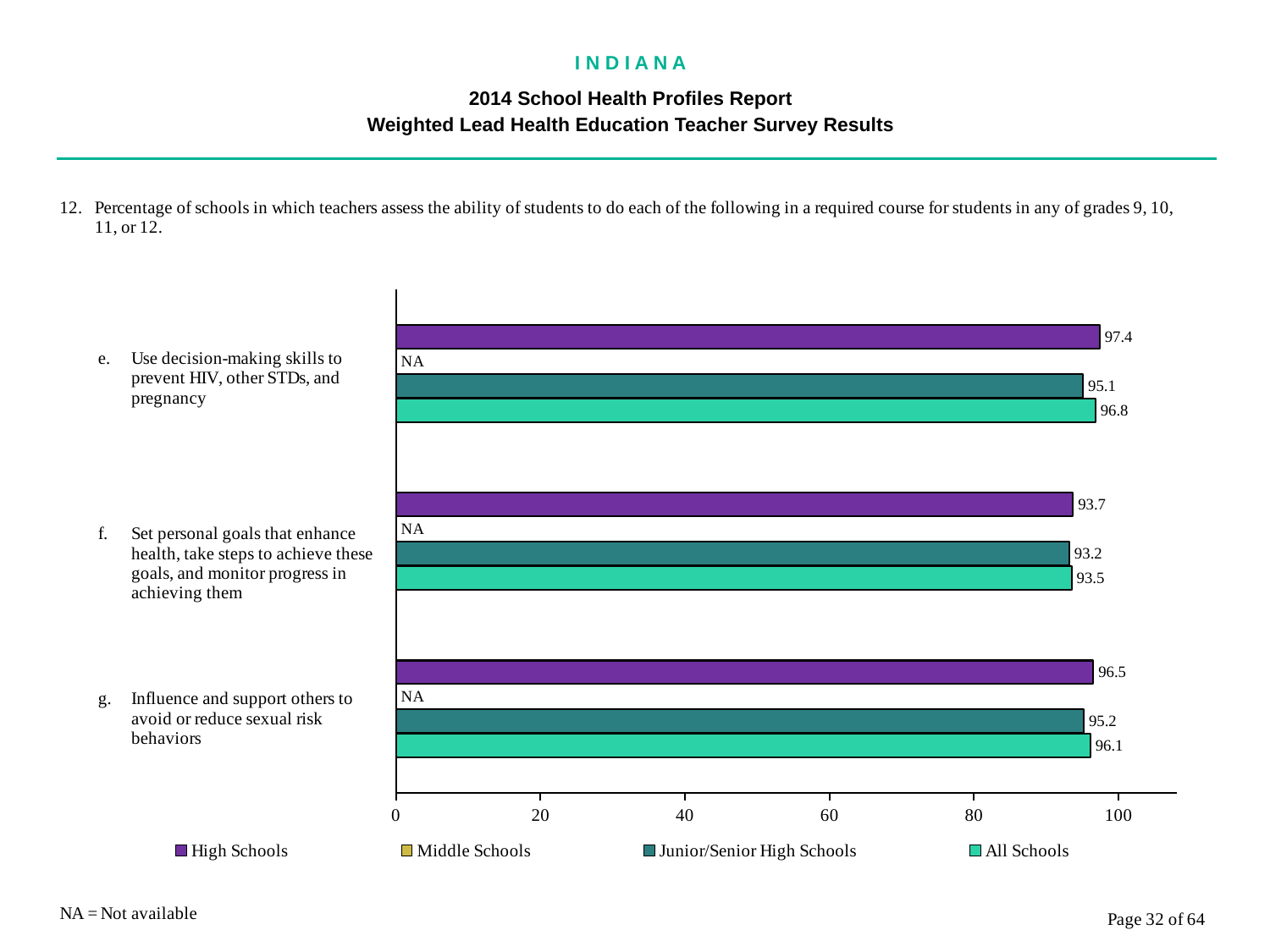
Which legend entry is shown in purple? High Schools What is the Junior/Senior High Schools value for item g, 'Influence and support others to avoid or reduce sexual risk behaviors'? 95.2 Which item has the highest High Schools value? e. Use decision-making skills to prevent HIV, other STDs, and pregnancy What is the High Schools value for item e, 'Use decision-making skills to prevent HIV, other STDs, and pregnancy'? 97.4 How many series does the legend list? 4 What is the All Schools value for item f, 'Set personal goals that enhance health...'? 93.5 What kind of chart is shown on the slide? Bar chart What value is shown for Middle Schools for item e? NA For item g, which is larger: the High Schools value or the All Schools value? High Schools Which item has the lowest Junior/Senior High Schools value? f. Set personal goals that enhance health, take steps to achieve these goals, and monitor progress in achieving them What is the difference between the High Schools and Junior/Senior High Schools values for item e? 2.3 How many items (categories) are shown on the chart? 3